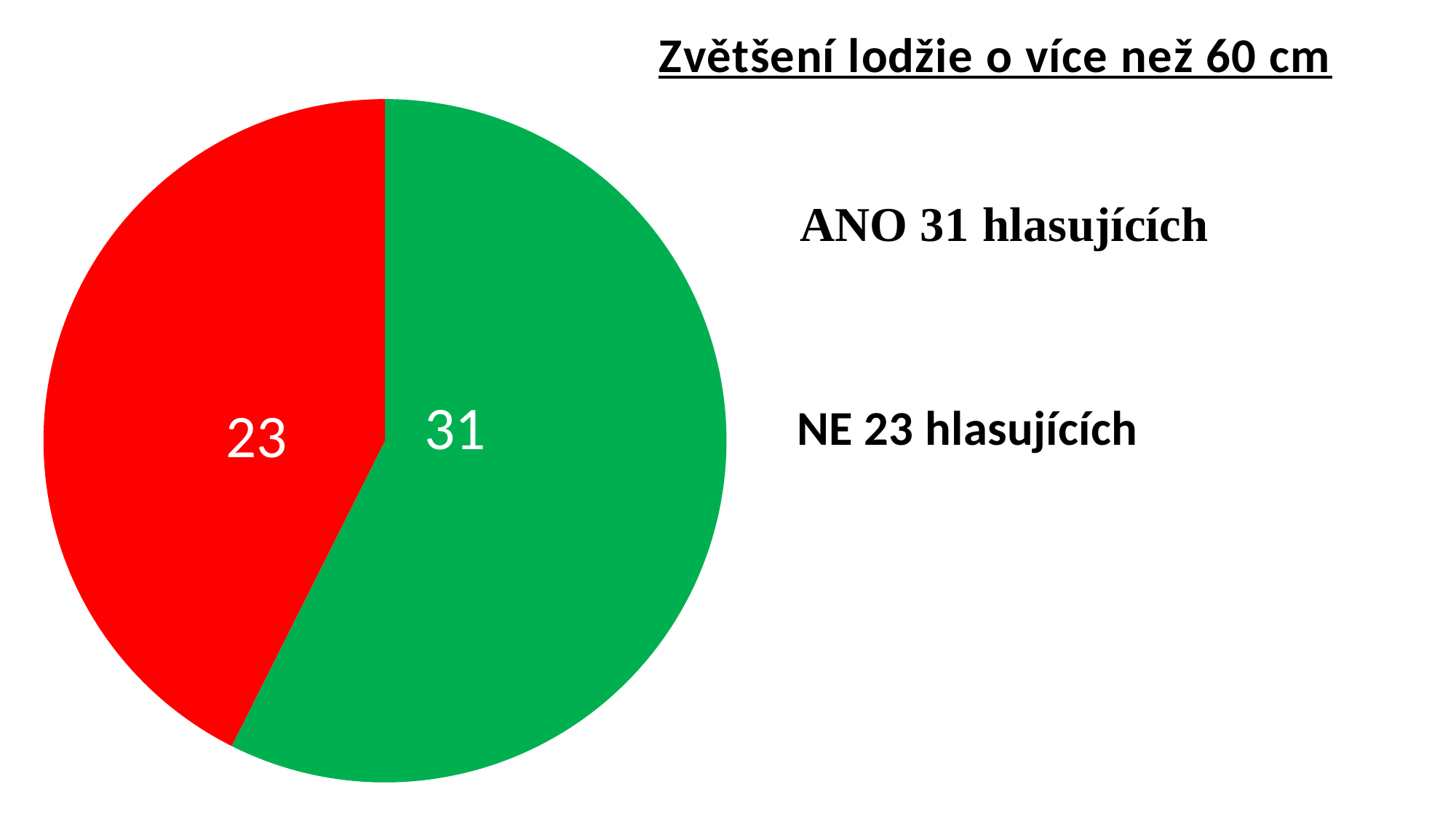
What type of chart is shown on the slide? pie chart What share of the total votes does the ANO slice represent? 57.4% Is the ANO slice larger or smaller than the NE slice? larger How many slices does the pie chart have? 2 What colour is the slice representing NE votes? red How many votes does the green (ANO) slice represent? 31 How many votes does the red (NE) slice represent? 23 What is the title of the chart on the slide? Zvětšení lodžie o více než 60 cm Which option received the most votes, ANO or NE? ANO Which option received the fewest votes? NE What is the total number of votes shown in the pie chart? 54 What is the difference between the ANO votes and the NE votes? 8